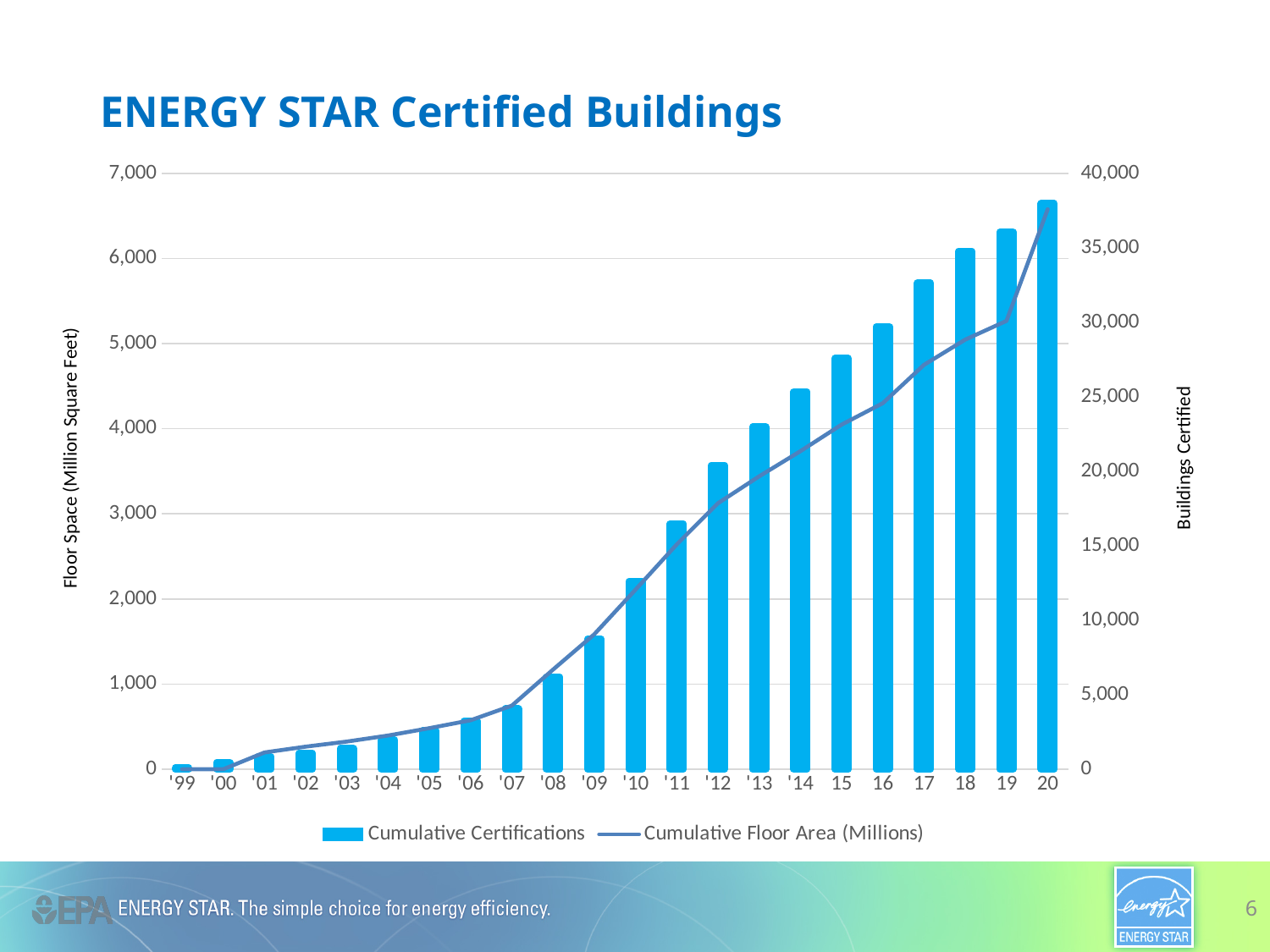
Is the Cumulative Floor Area value for 14 greater or less than 4,000? less Which year has the highest Cumulative Certifications bar? 20 Which is larger, the Cumulative Certifications bar for 20 or for '10? 20 What kind of chart is shown on the slide? A combination bar and line chart Is the Cumulative Certifications value for 20 greater or less than 35,000? greater What is the label of the left vertical axis? Floor Space (Million Square Feet) How many years are shown along the x axis? 22 Is the Cumulative Certifications value for '07 greater or less than 5,000? less Which year has the lowest Cumulative Certifications bar? '99 Do the Cumulative Certifications bars rise or fall from '99 to 20? Rise How many series does the legend list? 2